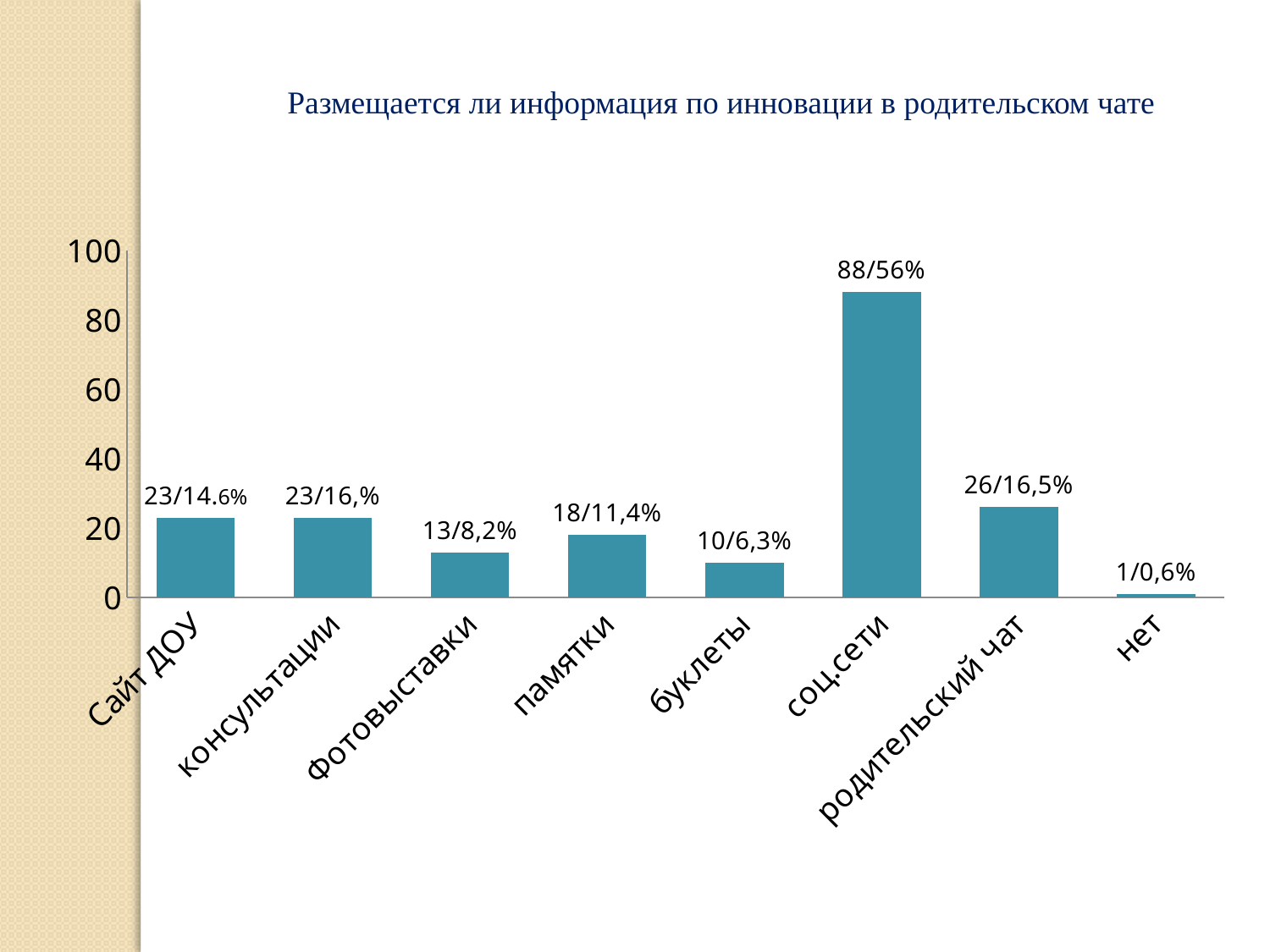
What is the title of the chart? Размещается ли информация по инновации в родительском чате Which category has the highest bar? соц.сети What type of chart is shown on the slide? bar chart Which bar is taller: фотовыставки or буклеты? фотовыставки What is the data label shown for соц.сети? 88/56% What is the data label shown for нет? 1/0,6% What is the data label shown for родительский чат? 26/16,5% What is the difference between the count for соц.сети (88) and the count for родительский чат (26)? 62 Which category has the lowest bar? нет What is the data label shown for памятки? 18/11,4% Is the bar for соц.сети greater or less than 80? greater How many categories are shown on the x axis of the chart? 8